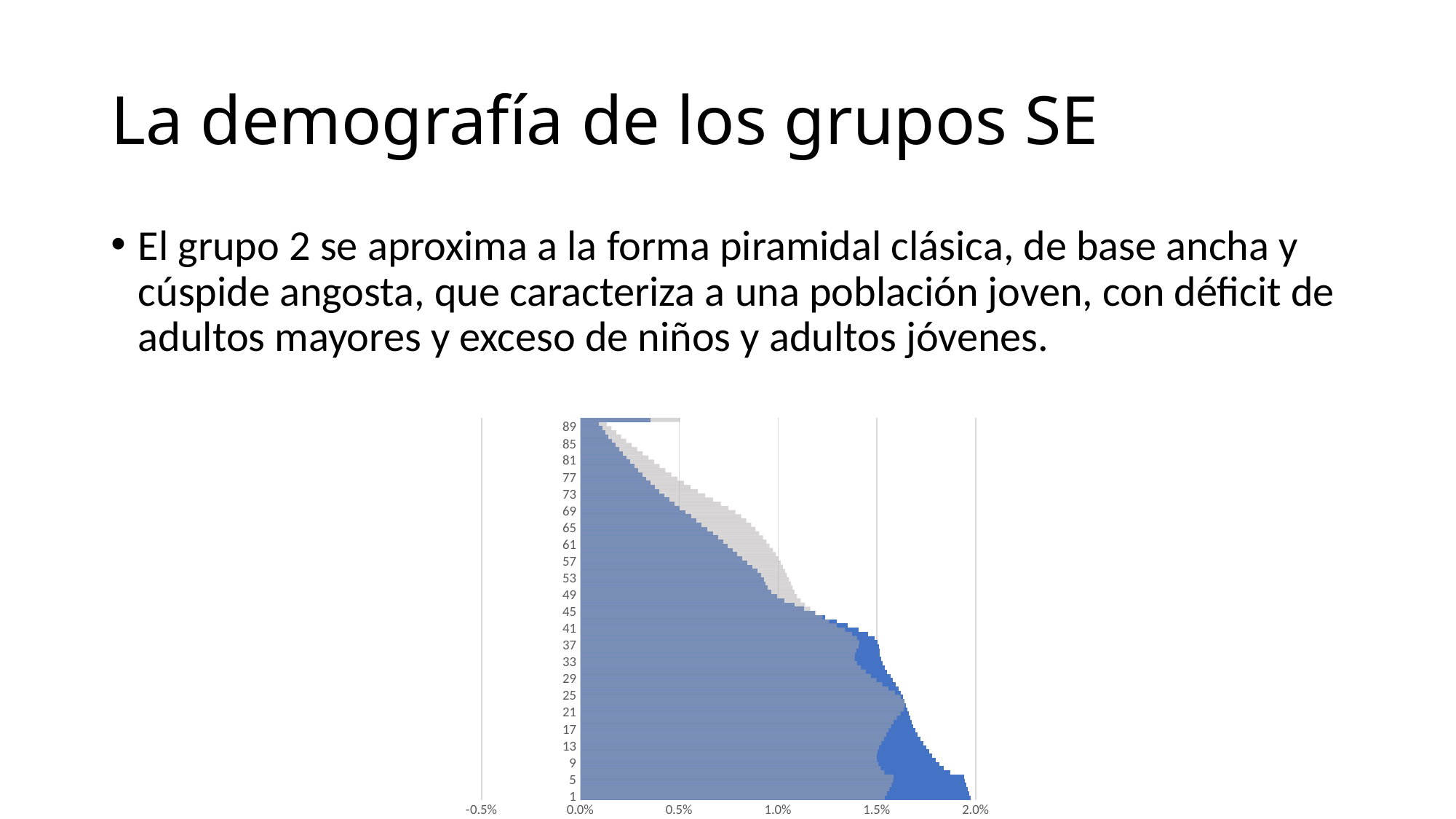
What is the highest value shown on the horizontal axis? 2.0% Is the value of the blue bar for age 45 greater or less than 1.0%? greater What kind of chart is shown on the slide? bar chart Is the value of the blue bar for age 89 greater or less than 0.5%? less Is the value of the blue bar for age 1 greater or less than 1.5%? greater At age 33, which series has the larger value, the blue one or the grey one? blue At age 65, which series has the larger value, the blue one or the grey one? grey Do the blue bars generally get longer or shorter as age increases from 1 to 89? shorter What is the highest age label shown on the vertical axis? 89